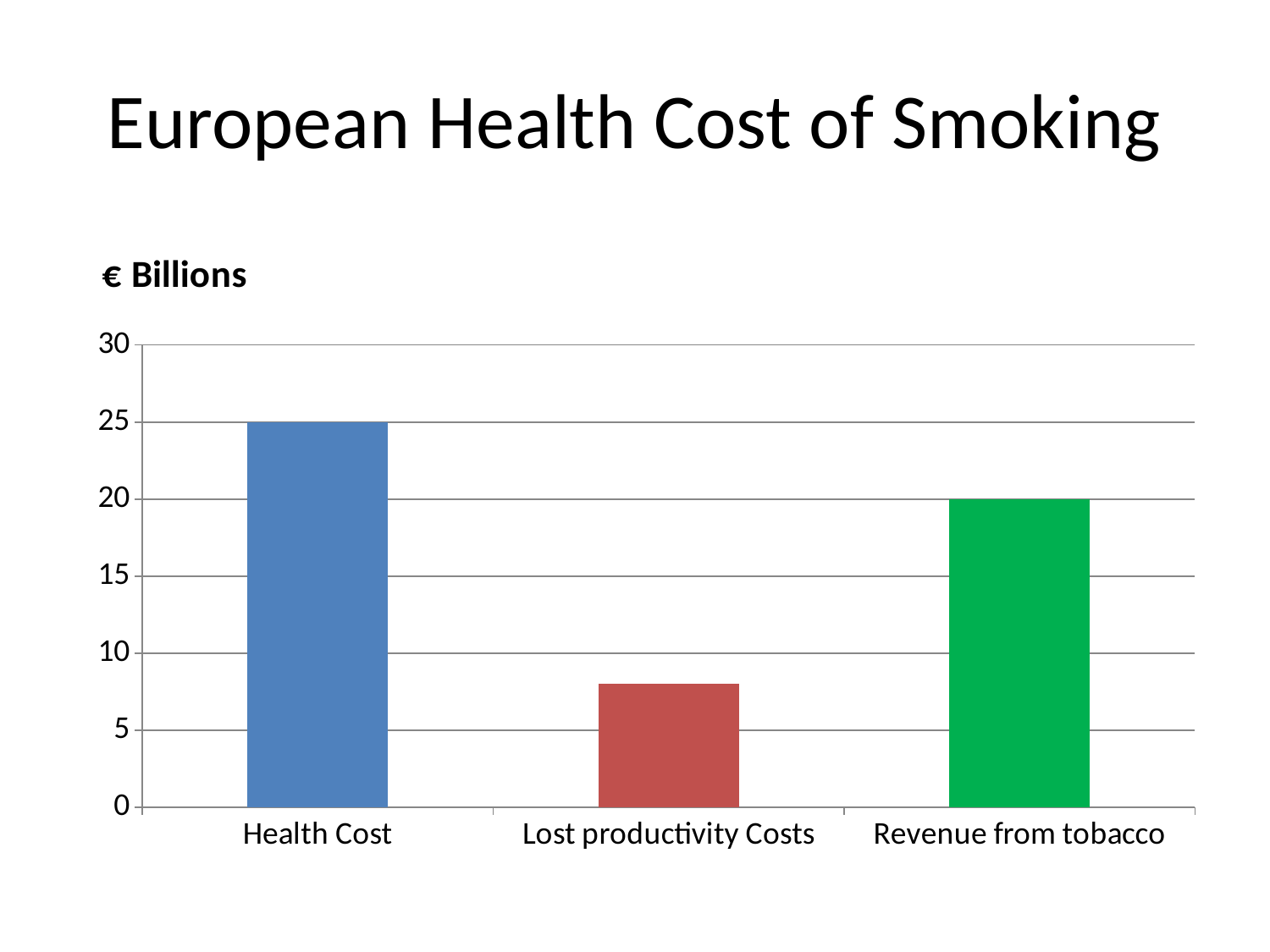
Which is larger, the value for Health Cost or the value for Revenue from tobacco? Health Cost Is the value for Lost productivity Costs greater or less than 5? greater Is the value for Lost productivity Costs greater or less than 10? less What is the value for Revenue from tobacco? 20 What is the difference between the value for Health Cost and the value for Revenue from tobacco? 5 What unit label is shown above the chart? € Billions Which category has the lowest value? Lost productivity Costs What kind of chart is shown on the slide? bar chart How many categories are plotted in the chart? 3 What is the title of the slide? European Health Cost of Smoking What is the value for Health Cost? 25 Which category has the highest value? Health Cost